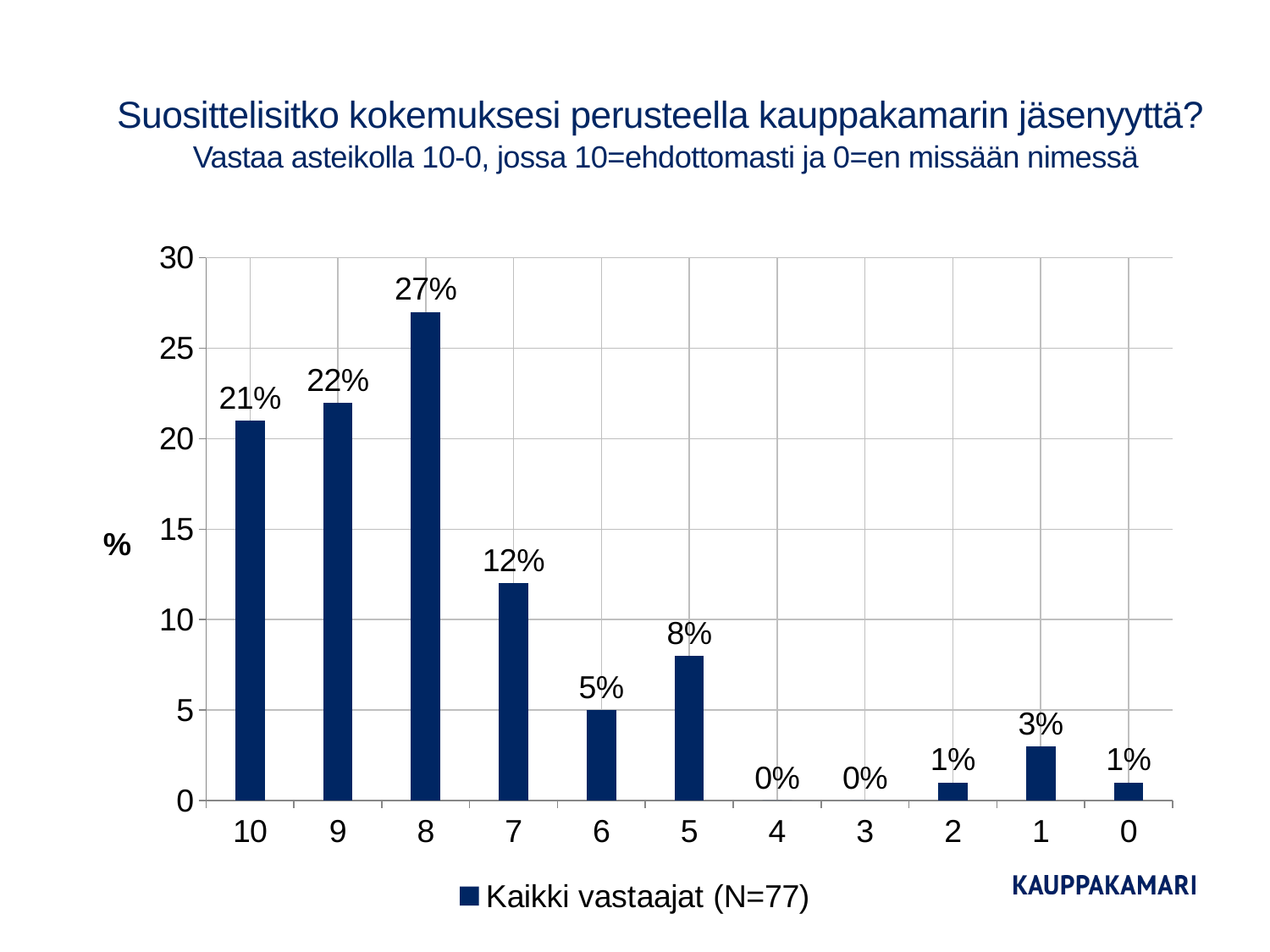
What percentage of respondents gave a rating of 10? 21% Which has a higher percentage of respondents, rating 9 or rating 10? 9 What is the difference in percentage points between the ratings 8 and 7? 15 Which rating categories have a value of 0%? 4 and 3 Which rating category has the highest percentage of respondents? 8 What kind of chart is shown on the slide? bar chart What percentage of respondents gave a rating of 8? 27% How many series does the legend list? 1 How many rating categories are shown on the x axis? 11 What percentage of respondents gave a rating of 5? 8% Is the value for rating 7 greater or less than 10? greater What is the legend entry for the series shown? Kaikki vastaajat (N=77)